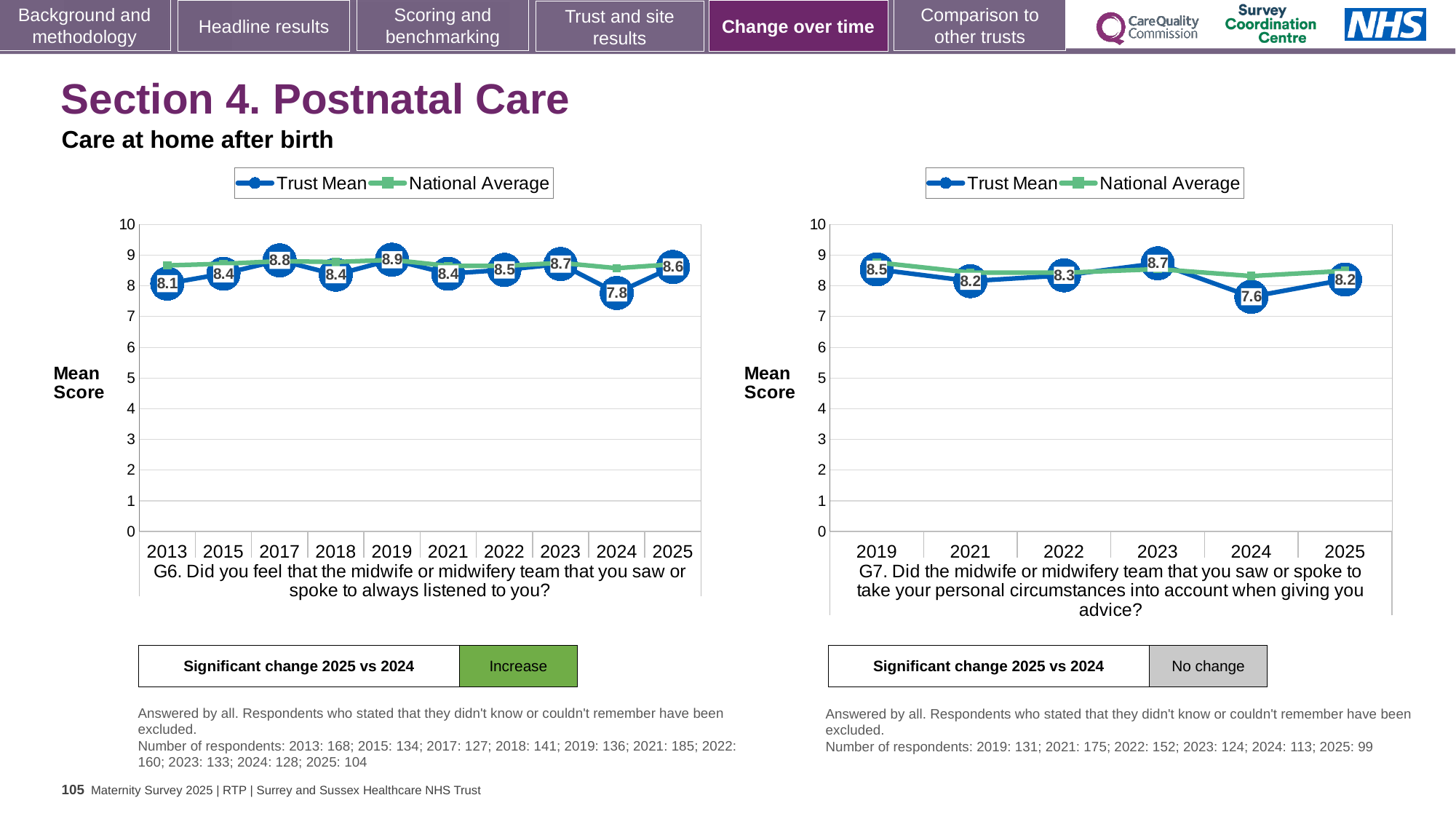
In the left chart (G6), what is the Trust Mean score for 2025? 8.6 In the left chart (G6), what is the Trust Mean score for 2013? 8.1 How many series does the legend of the right chart (G7) list? 2 In the right chart (G7), what is the Trust Mean score for 2024? 7.6 What kind of chart is the left chart (G6)? Line chart In the left chart (G6), which year has the lowest Trust Mean score? 2024 In the right chart (G7), is the Trust Mean score for 2019 larger or smaller than the score for 2025? larger In the left chart (G6), what is the difference between the Trust Mean scores for 2025 and 2024? 0.8 In the left chart (G6), how many years are shown on the x axis? 10 In the right chart (G7), which year has the highest Trust Mean score? 2023 In the left chart (G6), which year has the highest Trust Mean score? 2019 In the right chart (G7), how many years are shown on the x axis? 6